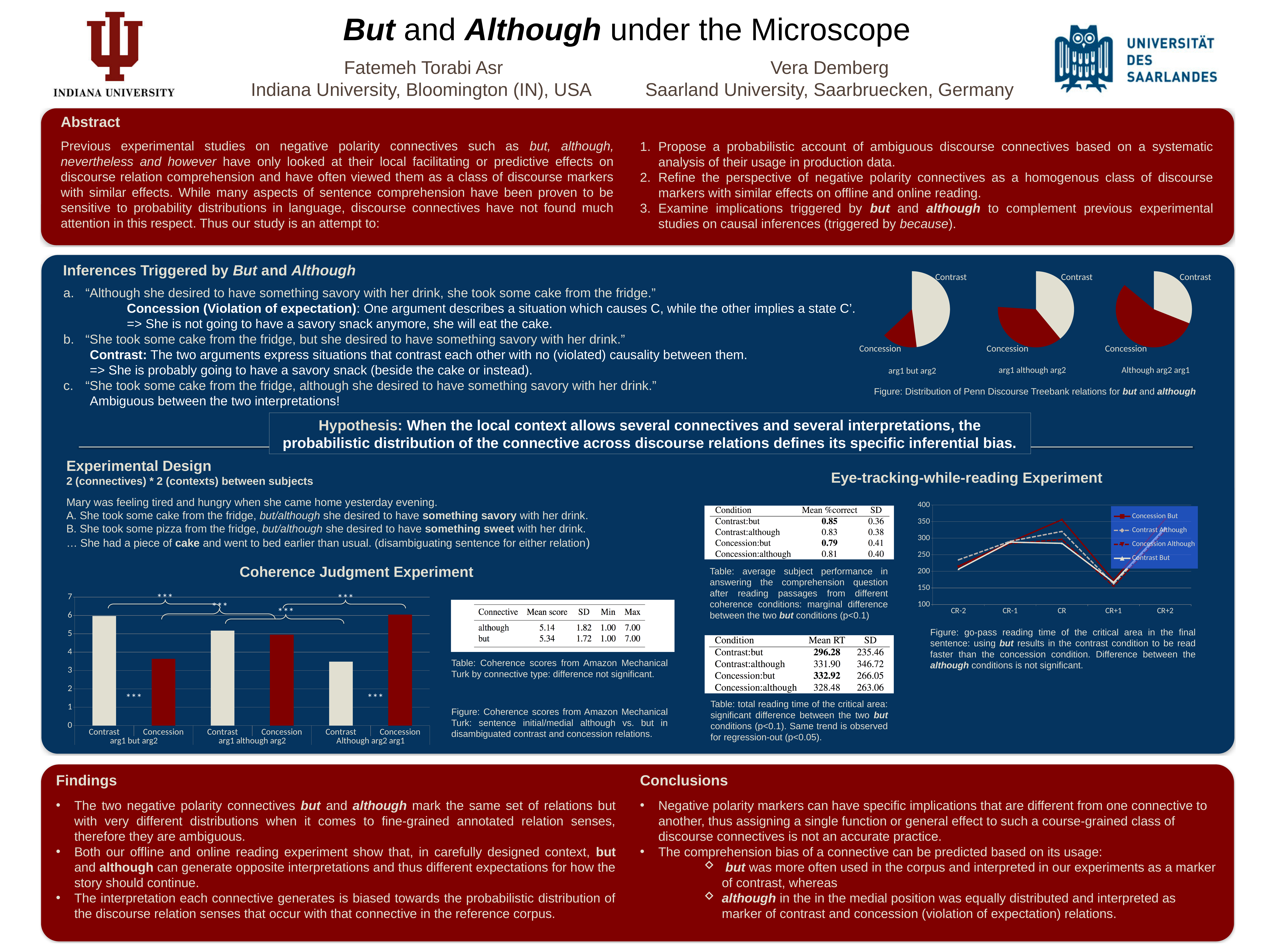
In the Coherence Judgment Experiment chart, is the Contrast value for arg1 but arg2 greater or less than 5? greater In the Coherence Judgment Experiment chart, which is larger for Although arg2 arg1: Contrast or Concession? Concession How many points are on the x axis of the Eye-tracking-while-reading Experiment line chart? 5 What kind of chart is the Coherence Judgment Experiment chart? bar chart In the Coherence Judgment Experiment chart, is the Contrast value for Although arg2 arg1 greater or less than 4? less In the pie chart labelled arg1 but arg2, which slice is larger: Contrast or Concession? Contrast How many bars are plotted in the Coherence Judgment Experiment chart? 6 In the Eye-tracking-while-reading Experiment line chart, at which x-axis position do the lines reach their lowest value? CR+1 In the Eye-tracking-while-reading Experiment line chart, is the Concession But value at CR greater or less than 300? greater In the Coherence Judgment Experiment chart, which is larger for arg1 but arg2: Contrast or Concession? Contrast How many series does the legend of the Eye-tracking-while-reading Experiment line chart list? 4